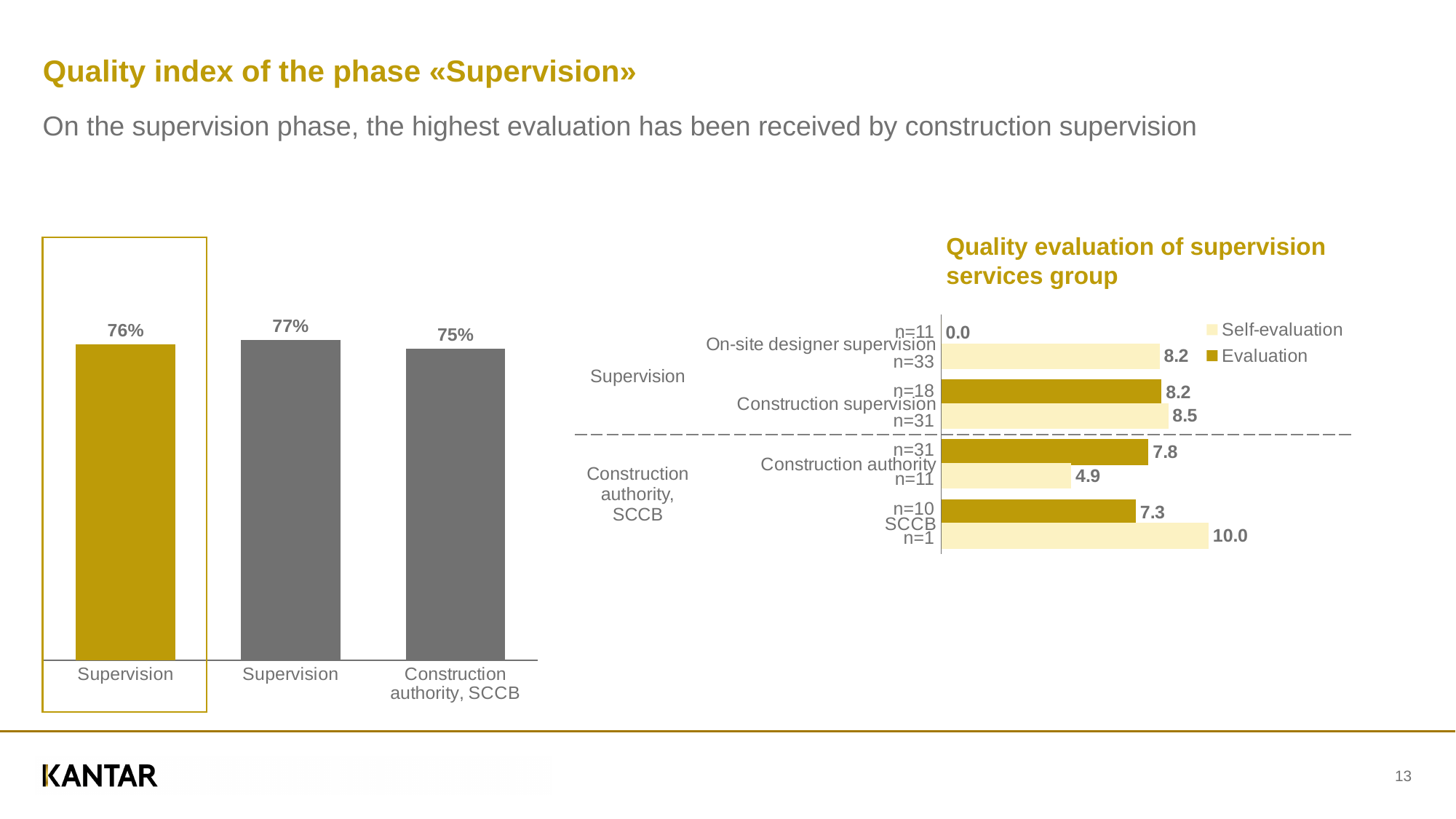
In the chart 'Quality evaluation of supervision services group', what is the Self-evaluation value for Construction authority? 4.9 In the chart 'Quality evaluation of supervision services group', which category has the lowest Evaluation value? On-site designer supervision What kind of chart is 'Quality evaluation of supervision services group'? Bar chart In the chart 'Quality evaluation of supervision services group', how many series does the legend list? 2 In the chart 'Quality evaluation of supervision services group', what is the difference between the Self-evaluation and Evaluation values for SCCB? 2.7 In the left bar chart, what is the value of the middle grey bar labelled Supervision? 77% In the chart 'Quality evaluation of supervision services group', what is the Self-evaluation value for SCCB? 10.0 In the left bar chart, what is the difference between the middle Supervision bar and the Construction authority, SCCB bar? 2% In the chart 'Quality evaluation of supervision services group', what is the Evaluation value for Construction supervision? 8.2 In the left bar chart, how many bars are plotted? 3 In the left bar chart, what is the value for Construction authority, SCCB? 75% In the left bar chart, what is the value of the highlighted leftmost bar labelled Supervision? 76%